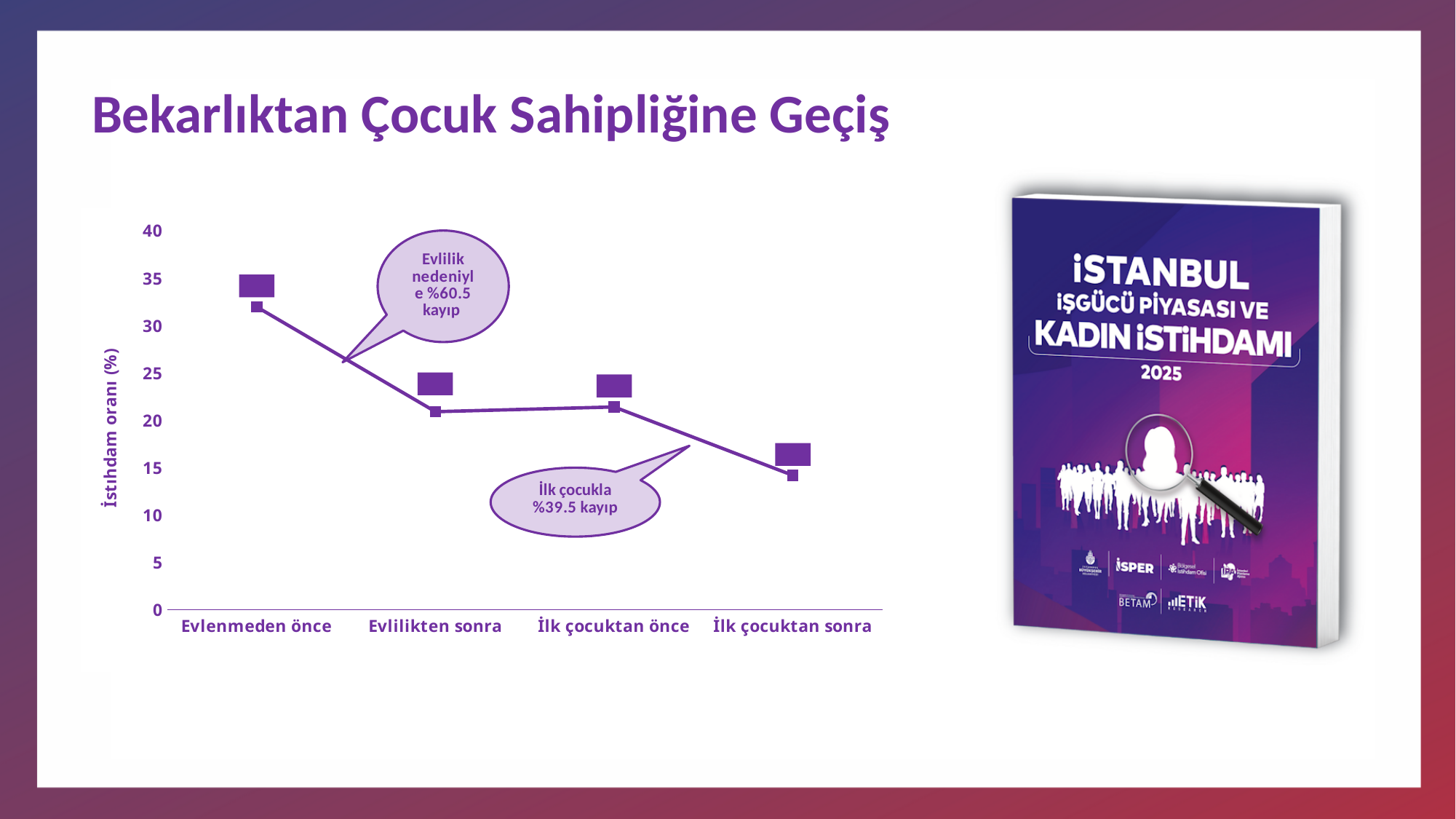
Is the value for Evlenmeden önce greater or less than 25? greater Is the value for İlk çocuktan sonra greater or less than 20? less What is the label on the y axis of the chart? İstihdam oranı (%) Which category has the highest employment rate in the chart? Evlenmeden önce According to the callout on the chart, what percentage loss is attributed to marriage (Evlilik nedeniyle)? %60.5 Do the values generally rise or fall from Evlenmeden önce to İlk çocuktan sonra? fall Which category has the lowest employment rate in the chart? İlk çocuktan sonra Which is larger, the value for Evlenmeden önce or the value for İlk çocuktan sonra? Evlenmeden önce Is the value for Evlilikten sonra greater or less than 25? less What kind of chart is shown on the slide? line chart How many categories are plotted along the x axis of the chart? 4